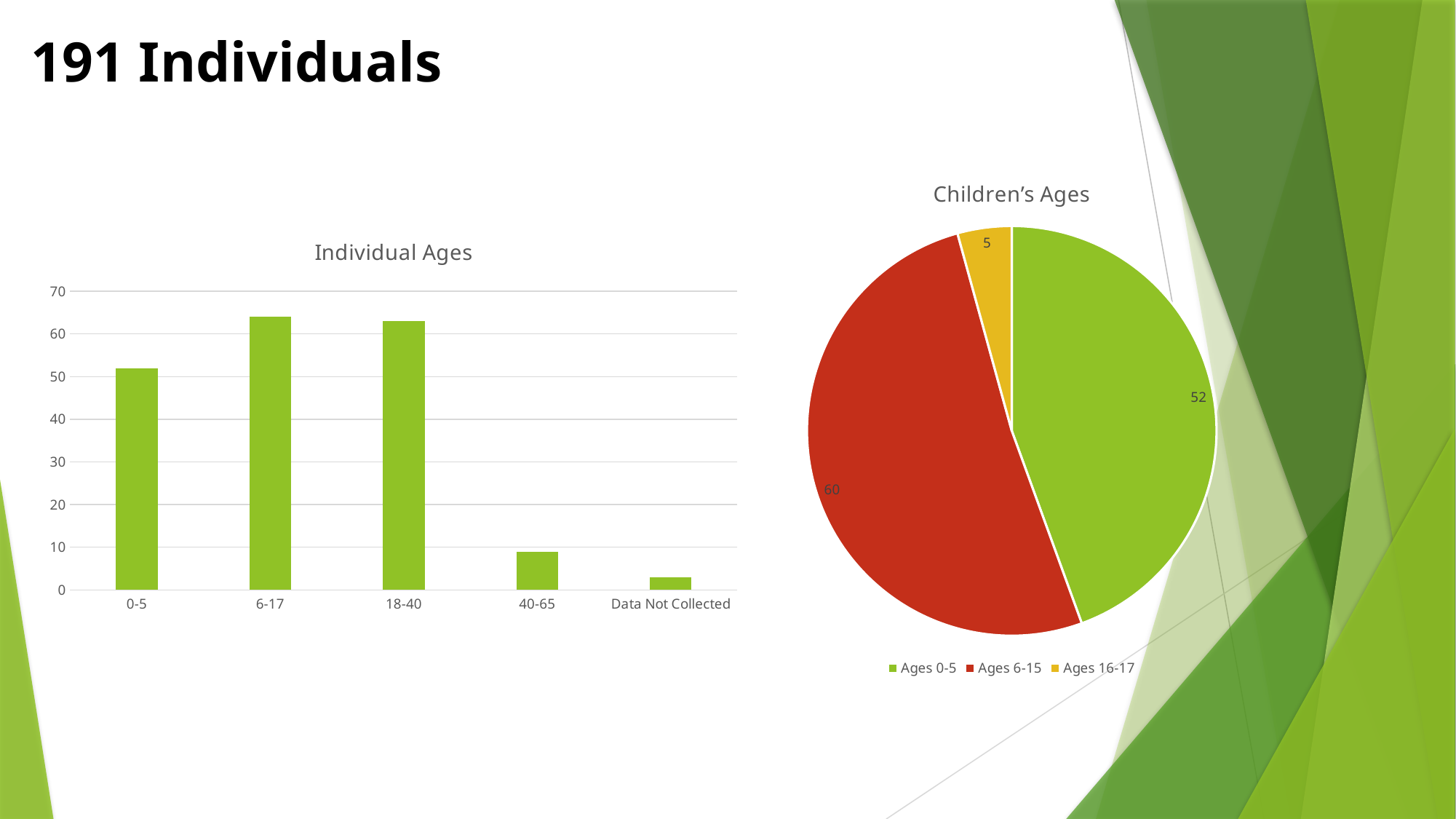
In the 'Individual Ages' chart, which is larger, the value for 0-5 or the value for 40-65? 0-5 In the 'Individual Ages' chart, is the value for 40-65 greater or less than 10? less What kind of chart is the 'Individual Ages' chart? bar chart In the 'Children's Ages' chart, what is the difference between the values for Ages 6-15 and Ages 0-5? 8 How many entries does the legend of the 'Children's Ages' chart list? 3 In the 'Children's Ages' chart, what is the value for Ages 6-15? 60 In the 'Children's Ages' chart, what is the value for Ages 16-17? 5 In the 'Individual Ages' chart, how many categories are shown on the x axis? 5 In the 'Individual Ages' chart, which category has the lowest value? Data Not Collected In the 'Individual Ages' chart, is the value for 6-17 greater or less than 60? greater What kind of chart is the 'Children's Ages' chart? pie chart In the 'Individual Ages' chart, is the value for 0-5 greater or less than 50? greater